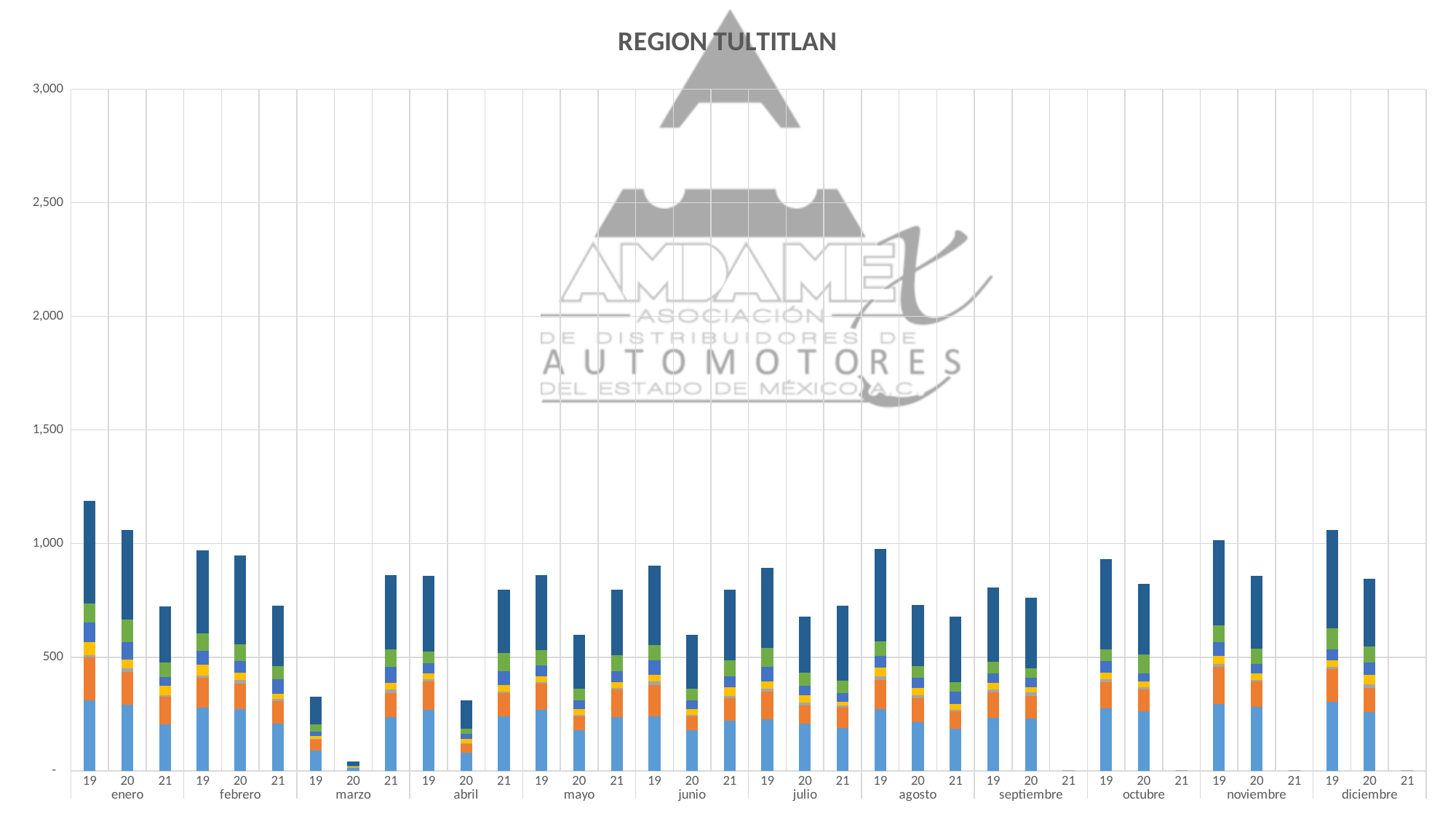
How many months are shown along the x axis? 12 What kind of chart is shown on the slide? Stacked bar chart Which is larger, the total for abril 20 or the total for abril 21? abril 21 Is the total for mayo 20 greater or less than 500? greater Is the total for marzo 19 greater or less than 500? less What is the highest value shown on the vertical axis? 3,000 Which bar is the tallest in the chart? enero 19 Is the total for enero 19 greater or less than 1,000? greater What is the title of the chart? REGION TULTITLAN Which bar is the shortest among the bars that are visible in the chart? marzo 20 Which is larger, the total for enero 19 or the total for enero 20? enero 19